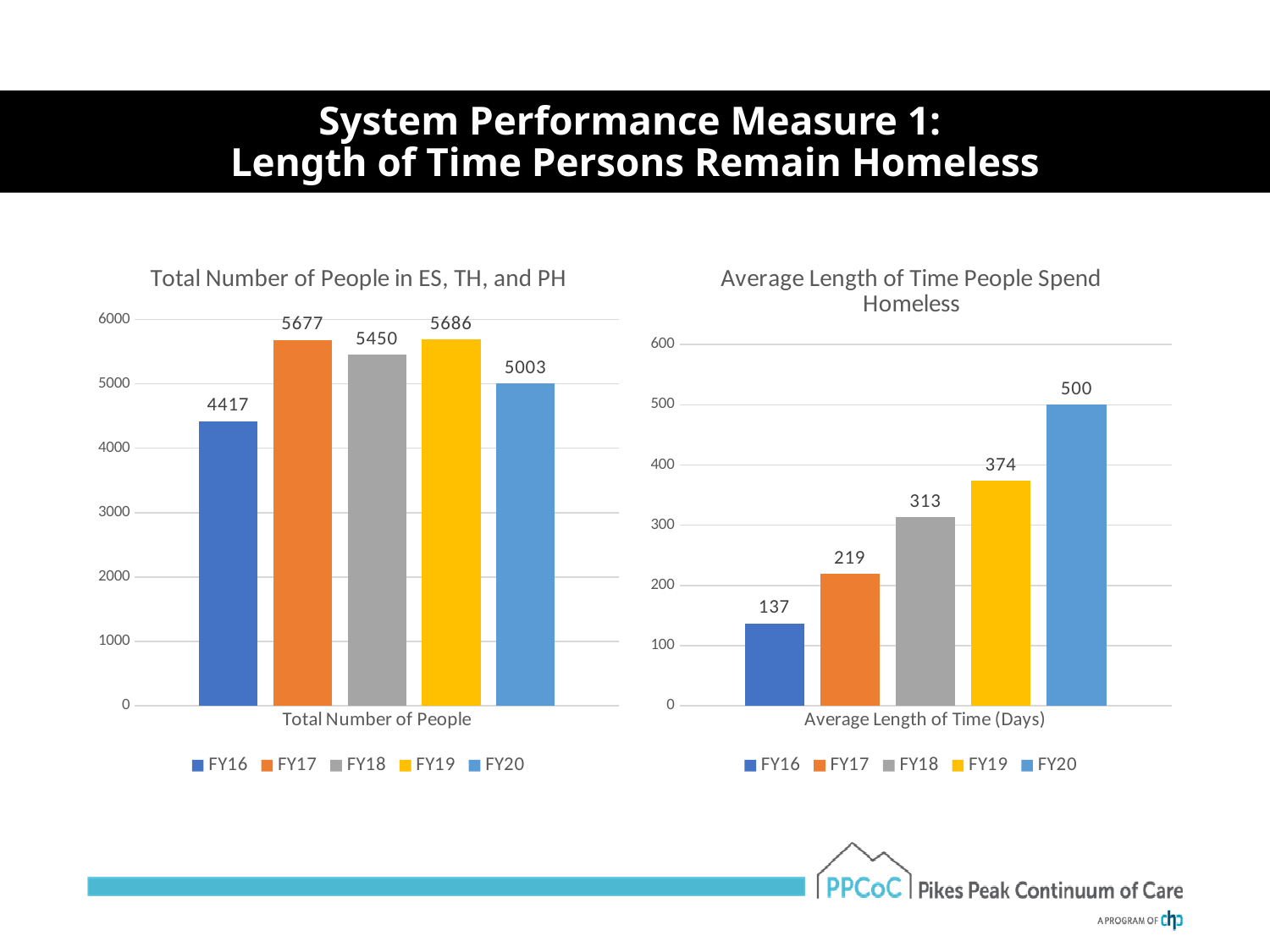
In the 'Average Length of Time People Spend Homeless' chart, what is the value for FY18? 313 What kind of chart is the 'Average Length of Time People Spend Homeless' chart? bar chart In the 'Average Length of Time People Spend Homeless' chart, what is the x-axis category label? Average Length of Time (Days) In the 'Total Number of People in ES, TH, and PH' chart, what is the difference between the FY17 and FY20 values? 674 In the 'Total Number of People in ES, TH, and PH' chart, what is the value for FY16? 4417 In the 'Total Number of People in ES, TH, and PH' chart, how many series does the legend list? 5 In the 'Average Length of Time People Spend Homeless' chart, what is the difference between the FY20 and FY16 values? 363 In the 'Total Number of People in ES, TH, and PH' chart, which fiscal year has the lowest value? FY16 In the 'Average Length of Time People Spend Homeless' chart, which is larger, the FY17 value or the FY19 value? FY19 In the 'Average Length of Time People Spend Homeless' chart, what is the value for FY20? 500 In the 'Total Number of People in ES, TH, and PH' chart, which fiscal year has the highest value? FY19 In the 'Average Length of Time People Spend Homeless' chart, do the values rise or fall from FY16 to FY20? rise